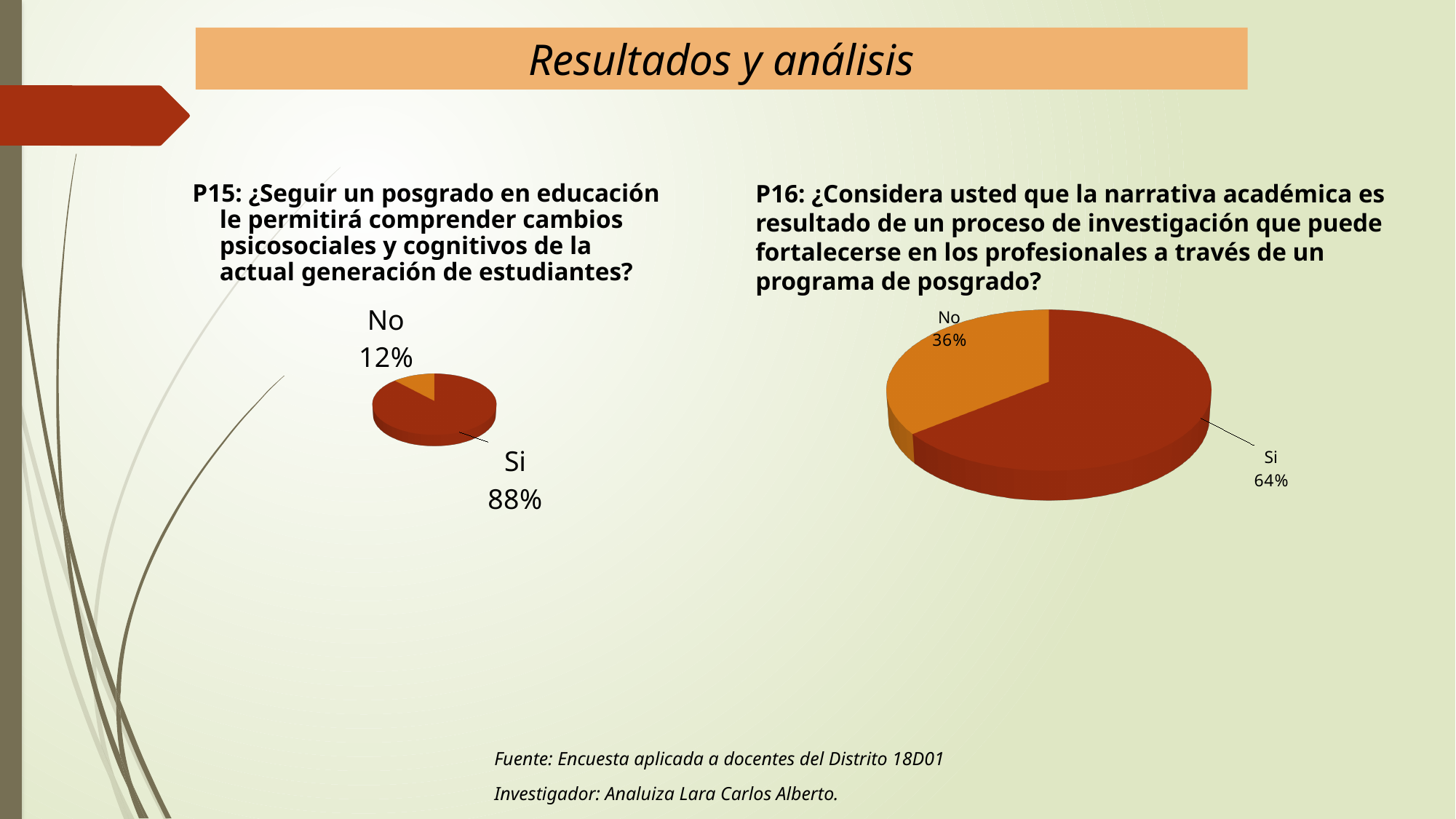
In the P16 pie chart on the right, which response has the smallest share? No What type of chart is used for P15 on the left? Pie chart In the P16 pie chart on the right, what percentage answered No? 36% How many slices does the P16 pie chart on the right have? 2 In the P16 pie chart on the right, what colour is the Si slice? Dark red Is the Si share larger in the P15 chart on the left or in the P16 chart on the right? P15 In the P15 pie chart on the left, what percentage answered No? 12% In the P15 pie chart on the left, what is the difference in percentage points between Si and No? 76 In the P16 pie chart on the right, what is the difference in percentage points between Si and No? 28 In the P16 pie chart on the right, what percentage answered Si? 64% In the P15 pie chart on the left, which response has the largest share? Si In the P15 pie chart on the left, what percentage answered Si? 88%